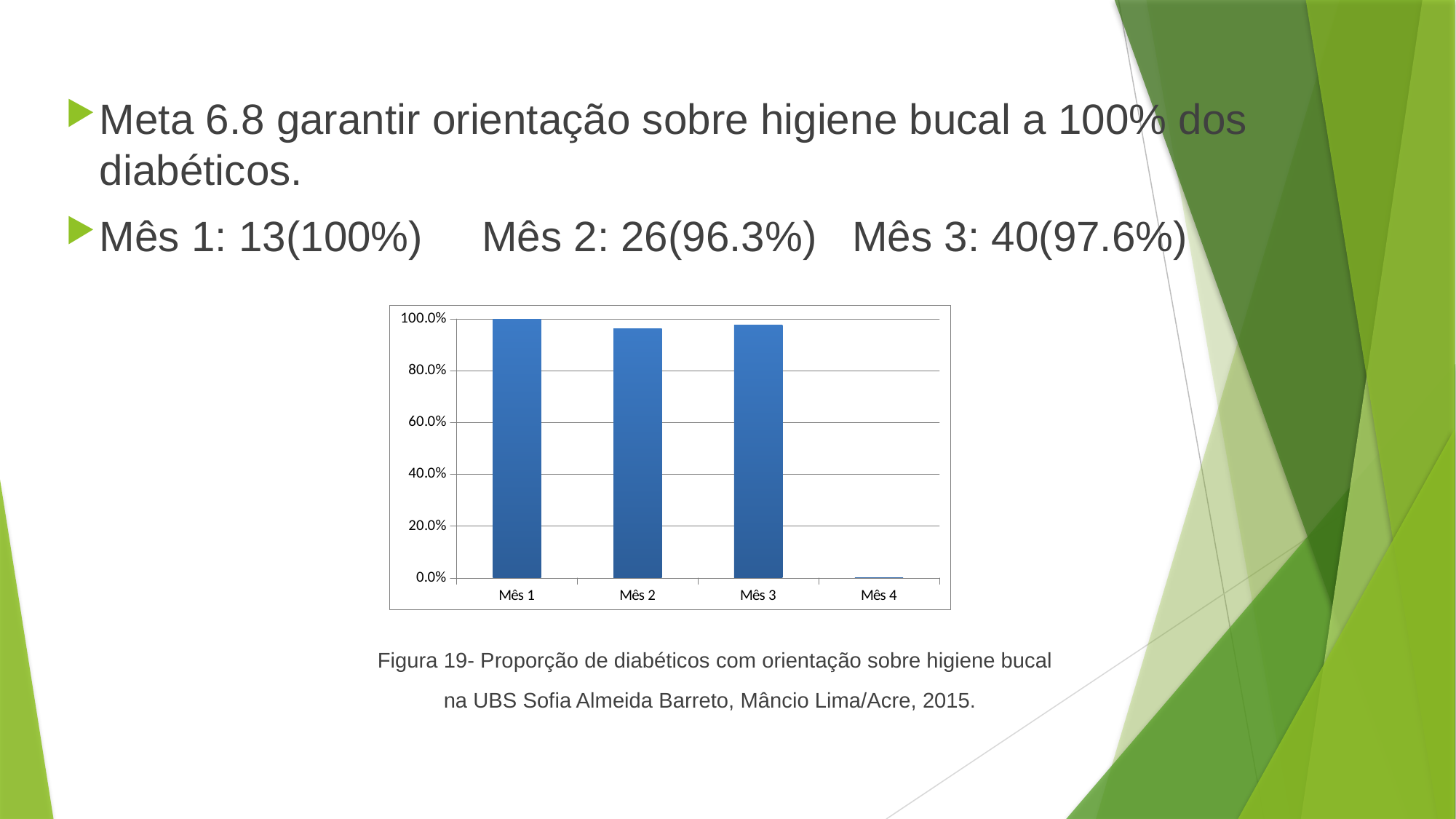
What kind of chart is shown on the slide? bar chart Is the value for Mês 2 greater or less than 80.0%? greater What is the difference between the values for Mês 1 and Mês 2 as stated on the slide? 3.7% According to the slide, what proportion is reported for Mês 3? 97.6% What is the value for Mês 1 in the chart? 100.0% How many categories (months) are shown on the x axis of the chart? 4 What is the figure number given in the caption below the chart? Figura 19 Which month has the highest bar in the chart? Mês 1 Which is larger, the value for Mês 1 or the value for Mês 2? Mês 1 Is the value for Mês 4 greater or less than 20.0%? less Which month has the lowest value in the chart? Mês 4 According to the slide, what proportion is reported for Mês 2? 96.3%